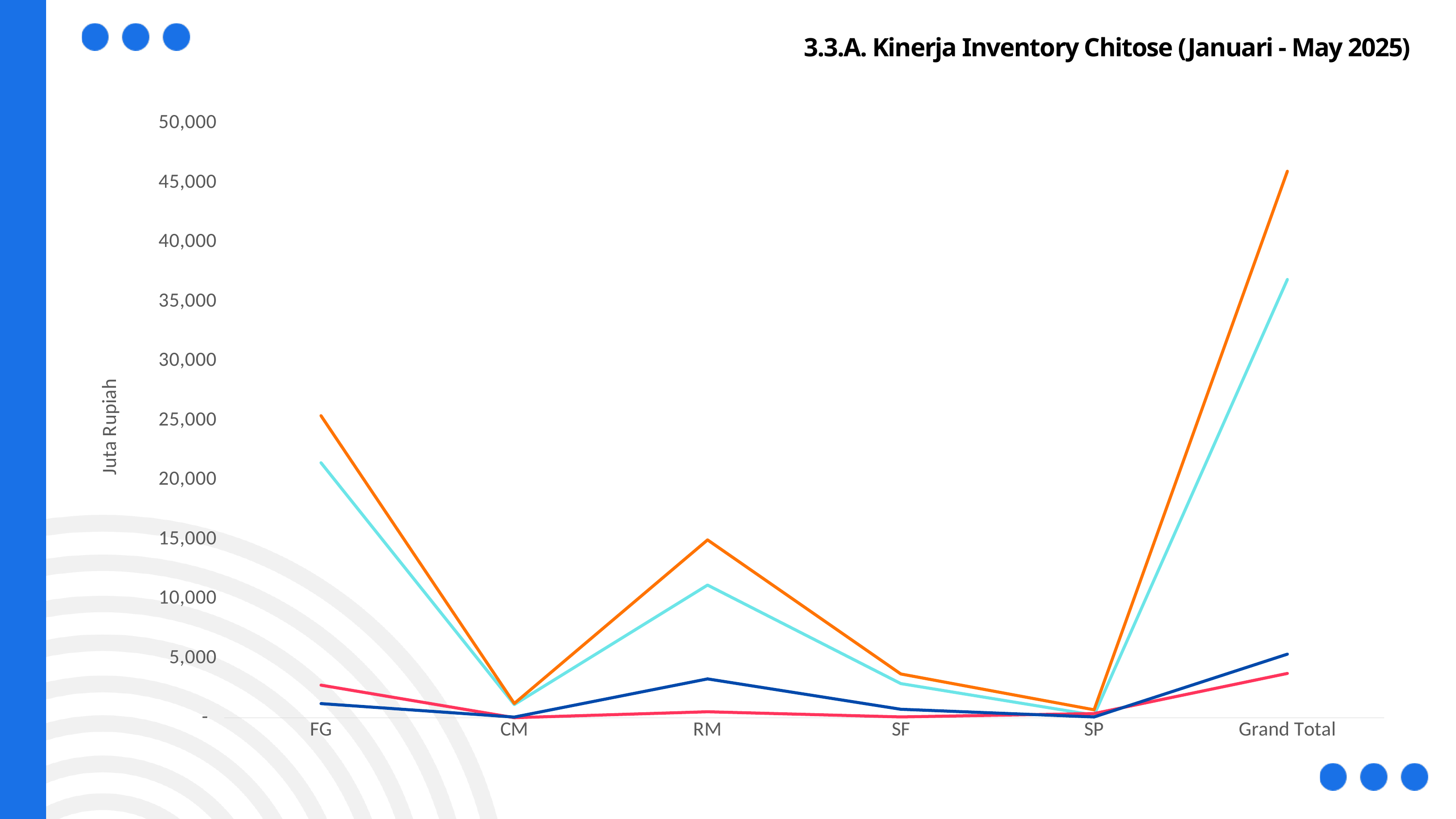
Is the value of the orange line at RM greater or less than 10,000? greater Is the value of the orange line at SF greater or less than 5,000? less How many categories are shown on the x axis of the chart? 6 For the orange line, is the value at FG or at RM larger? FG Is the value of the light blue line at Grand Total greater or less than 35,000? greater How many lines are plotted on the chart? 4 What is the label on the vertical axis of the chart? Juta Rupiah What kind of chart is shown on the slide? line chart At which category does the orange line reach its highest value? Grand Total What is the title of the chart on the slide? 3.3.A. Kinerja Inventory Chitose (Januari - May 2025)